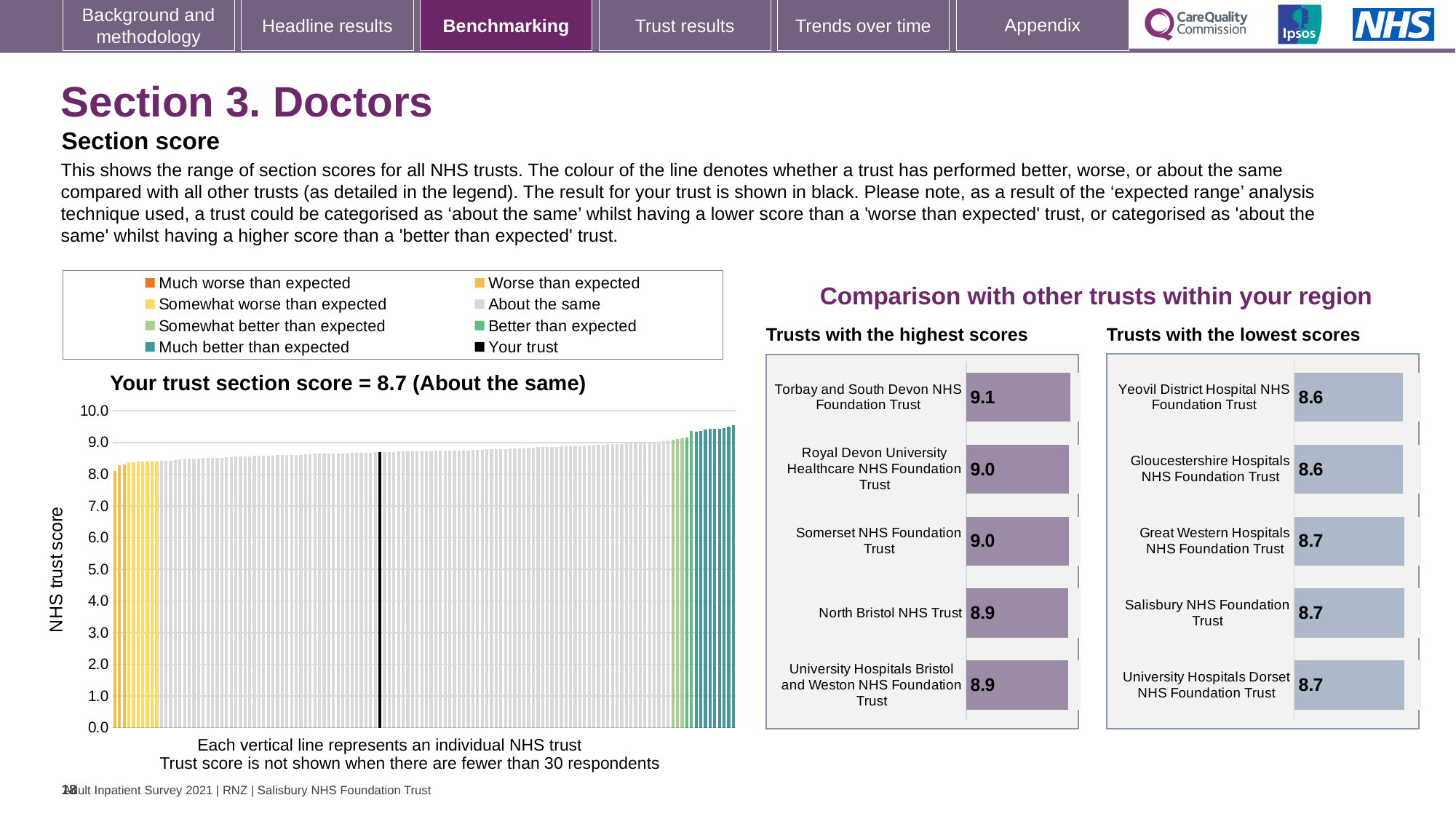
In the 'Your trust section score' chart, what is the section score for your trust? 8.7 Which is larger: the score for Torbay and South Devon NHS Foundation Trust in the 'Trusts with the highest scores' chart or the score for Yeovil District Hospital NHS Foundation Trust in the 'Trusts with the lowest scores' chart? Torbay and South Devon NHS Foundation Trust What kind of chart is the 'Your trust section score' chart? bar chart In the 'Trusts with the highest scores' chart, which trust has the highest score? Torbay and South Devon NHS Foundation Trust In the 'Trusts with the lowest scores' chart, what is the score for Salisbury NHS Foundation Trust? 8.7 In the 'Trusts with the highest scores' chart, what is the difference between the scores of Torbay and South Devon NHS Foundation Trust and North Bristol NHS Trust? 0.2 In the 'Trusts with the highest scores' chart, how many trusts are shown? 5 In the 'Your trust section score' chart, is the value of the highest bar greater or less than 9.0? greater In the 'Trusts with the lowest scores' chart, what is the score for Yeovil District Hospital NHS Foundation Trust? 8.6 In the 'Trusts with the highest scores' chart, what is the score for Torbay and South Devon NHS Foundation Trust? 9.1 In the 'Your trust section score' chart, what is the label on the vertical axis? NHS trust score In the 'Your trust section score' chart, how many entries does the legend list? 8